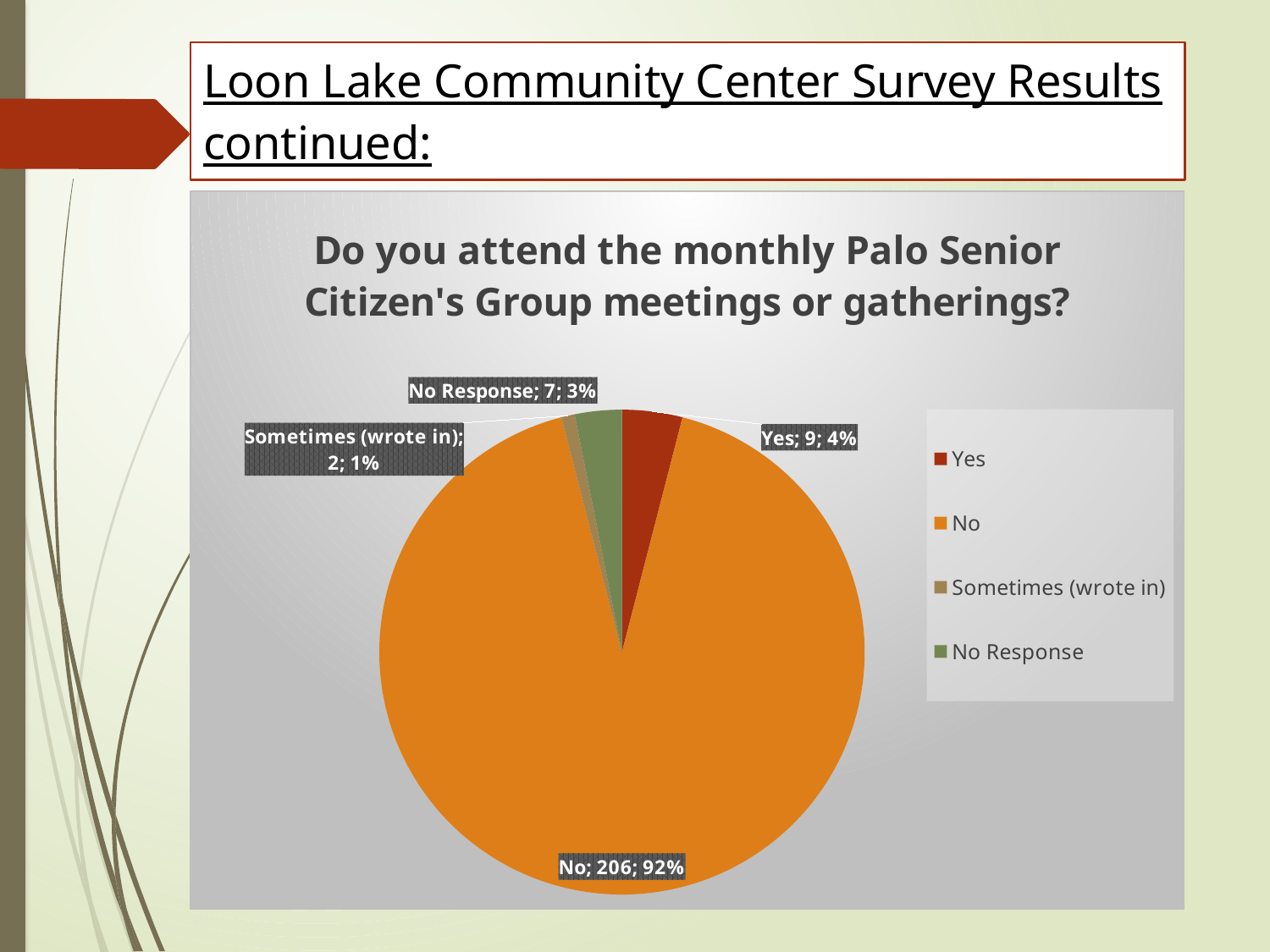
What kind of chart is shown on the slide? pie chart Which category has the largest slice of the pie? No What is the total number of responses across all four slices? 224 Which category has the smallest slice of the pie? Sometimes (wrote in) How many categories does the pie chart have? 4 What is the title of the pie chart? Do you attend the monthly Palo Senior Citizen's Group meetings or gatherings? What percentage of respondents answered "Yes"? 4% How many more respondents answered "No" than "Yes"? 197 How many respondents answered "No" to attending the monthly Palo Senior Citizen's Group meetings? 206 What share of the pie does "Sometimes (wrote in)" represent? 1% Which is larger, the count for "Yes" or the count for "No Response"? Yes How many respondents gave "No Response"? 7